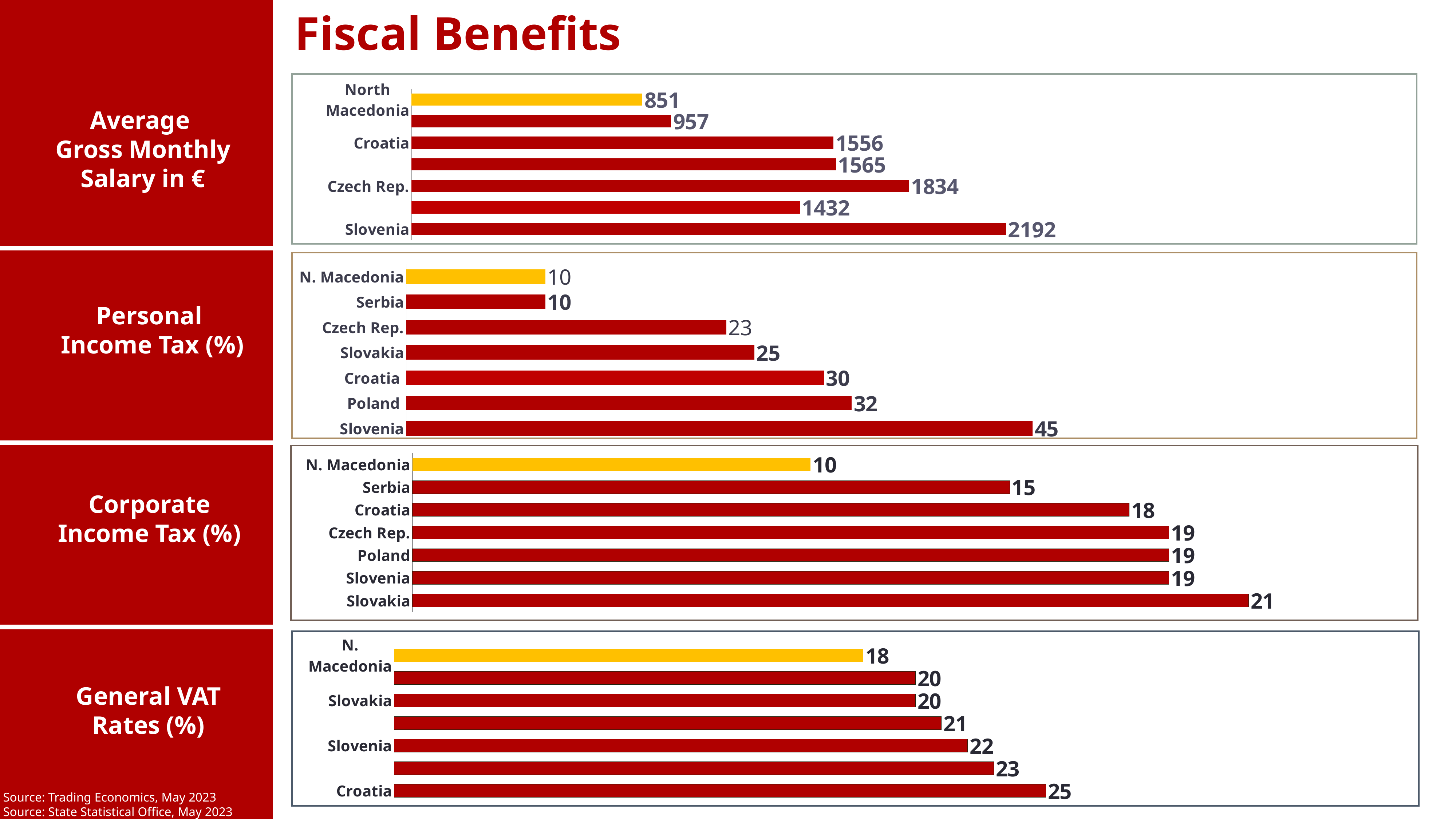
In the Corporate Income Tax (%) chart, which country has the highest rate? Slovakia In the Average Gross Monthly Salary in € chart, what is the difference between Czech Rep. and Croatia? 278 In the General VAT Rates (%) chart, what is the value for Croatia? 25 In the Personal Income Tax (%) chart, what is the value for Poland? 32 In the Corporate Income Tax (%) chart, which is larger, the value for Croatia or the value for Serbia? Croatia What kind of chart is the General VAT Rates (%) chart? Bar chart In the Personal Income Tax (%) chart, which country has the highest rate? Slovenia In the Corporate Income Tax (%) chart, what is the value for Serbia? 15 In the Personal Income Tax (%) chart, how many countries are shown? 7 In the General VAT Rates (%) chart, what is the difference between Croatia and N. Macedonia? 7 In the Average Gross Monthly Salary in € chart, which country has the lowest salary? North Macedonia In the Average Gross Monthly Salary in € chart, what is the value for Slovenia? 2192